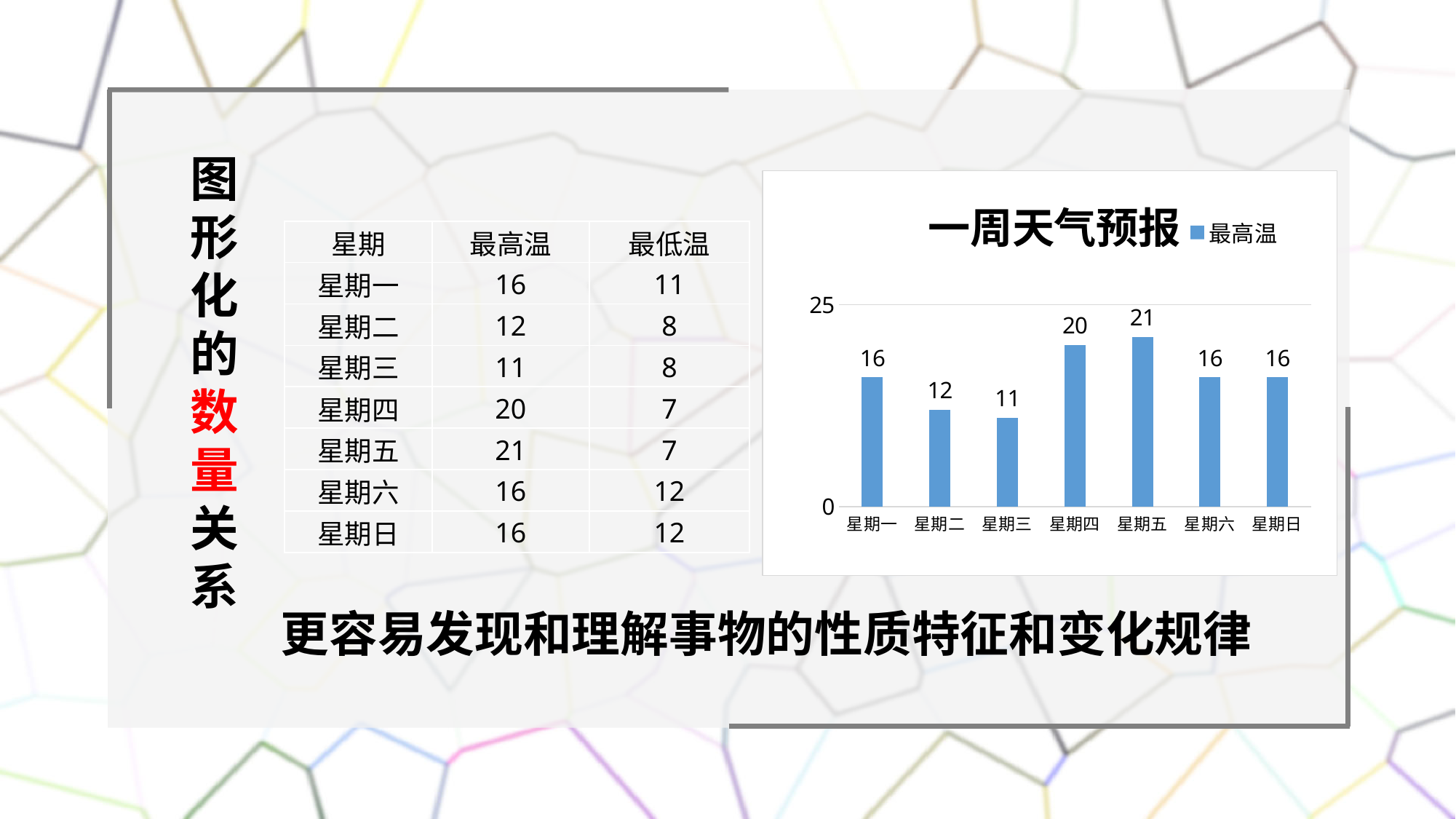
What kind of chart is shown on the slide? bar chart Which day has the highest value in the chart? 星期五 Which is larger, the value for 星期一 or the value for 星期二? 星期一 What series name is shown in the chart legend? 最高温 What is the difference between the values for 星期四 and 星期一? 4 What is the value for 星期四 in the chart? 20 How many days are shown on the x axis of the chart? 7 Which day has the lowest value in the chart? 星期三 How many series does the chart legend list? 1 What is the value for 星期二 in the chart? 12 What is the difference between the values for 星期五 and 星期三? 10 What is the title of the chart? 一周天气预报